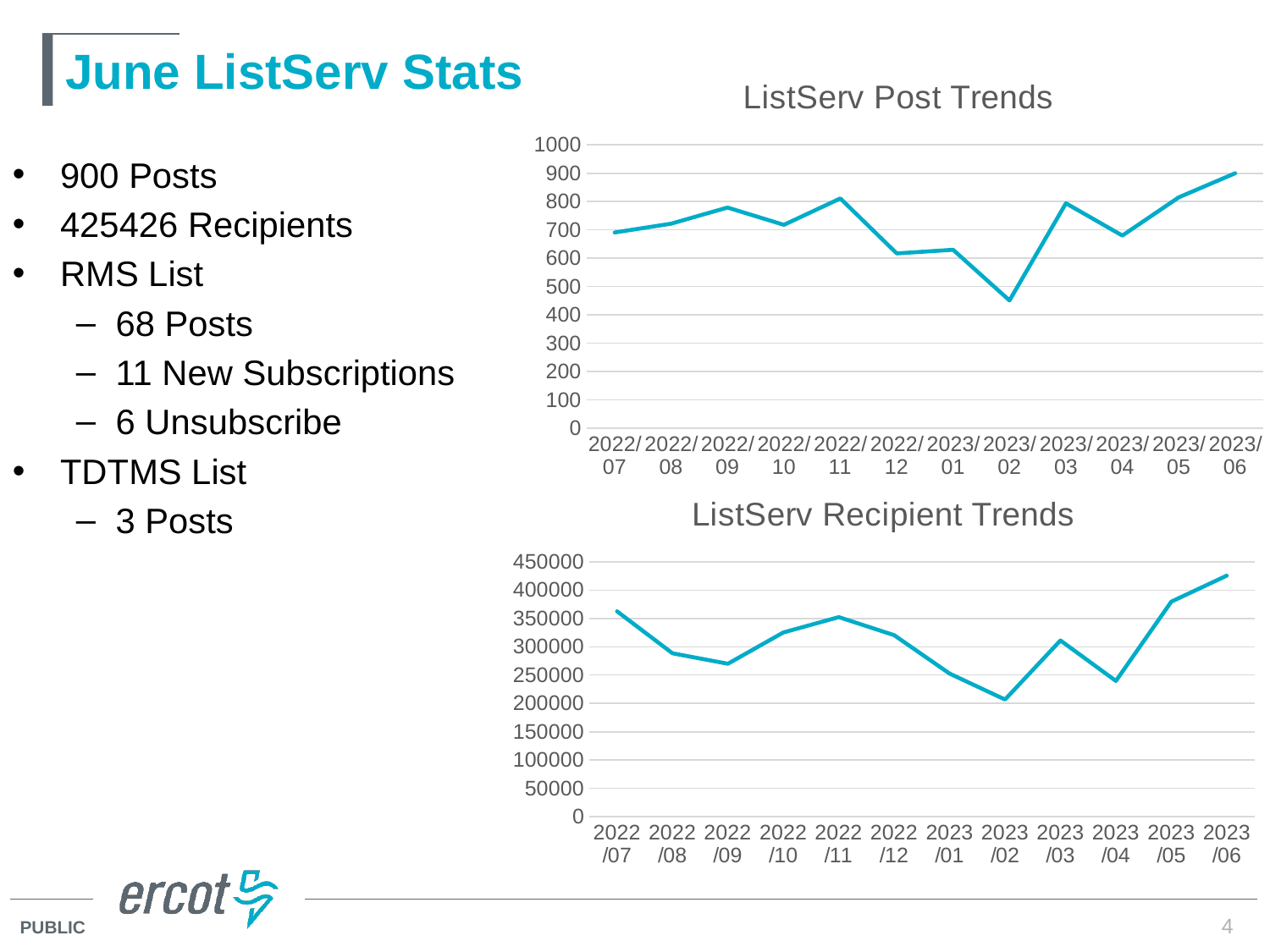
In the ListServ Recipient Trends chart, which month has the highest number of recipients? 2023/06 In the ListServ Recipient Trends chart, which is larger, the value for 2022/09 or the value for 2022/11? 2022/11 In the ListServ Recipient Trends chart, is the value for 2023/02 greater or less than 250000? less How many months are plotted in the ListServ Post Trends chart? 12 In the ListServ Recipient Trends chart, do the values rise or fall from 2023/04 to 2023/06? rise In the ListServ Post Trends chart, is the value for 2023/02 greater or less than 500? less What kind of chart is the ListServ Post Trends chart? line chart In the ListServ Post Trends chart, is the value for 2022/09 greater or less than 700? greater In the ListServ Recipient Trends chart, which month has the lowest number of recipients? 2023/02 In the ListServ Post Trends chart, which month has the highest number of posts? 2023/06 In the ListServ Post Trends chart, what is the value for 2023/06? 900 In the ListServ Post Trends chart, which month has the lowest number of posts? 2023/02